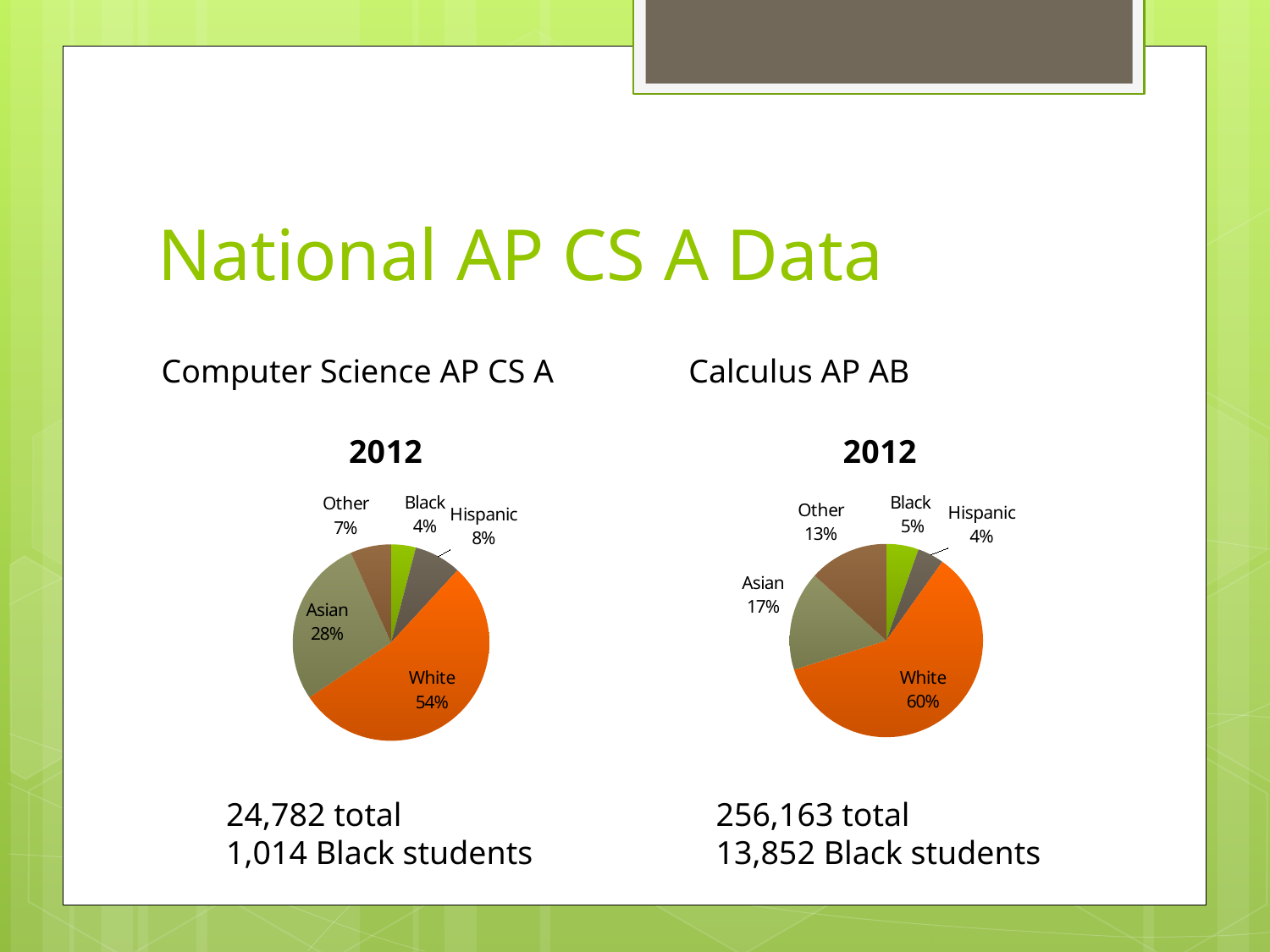
In the Computer Science AP CS A pie chart, which category has the largest slice? White In the Calculus AP AB pie chart, what percentage is shown for White? 60% Which is larger: the Asian share in the Computer Science AP CS A chart or the Asian share in the Calculus AP AB chart? Computer Science AP CS A In the Computer Science AP CS A pie chart, which category has the smallest slice? Black In the Computer Science AP CS A pie chart, what percentage is shown for Asian? 28% In the Calculus AP AB pie chart, what is the combined percentage of Black and Hispanic students? 9% What type of chart is used for the Computer Science AP CS A data? Pie chart What is the title shown above each pie chart? 2012 How many categories does the Calculus AP AB pie chart show? 5 In the Computer Science AP CS A pie chart, what is the difference between the White and Asian percentages? 26% In the Calculus AP AB pie chart, what percentage is shown for Hispanic? 4% In the Calculus AP AB pie chart, which category has the smallest slice? Hispanic